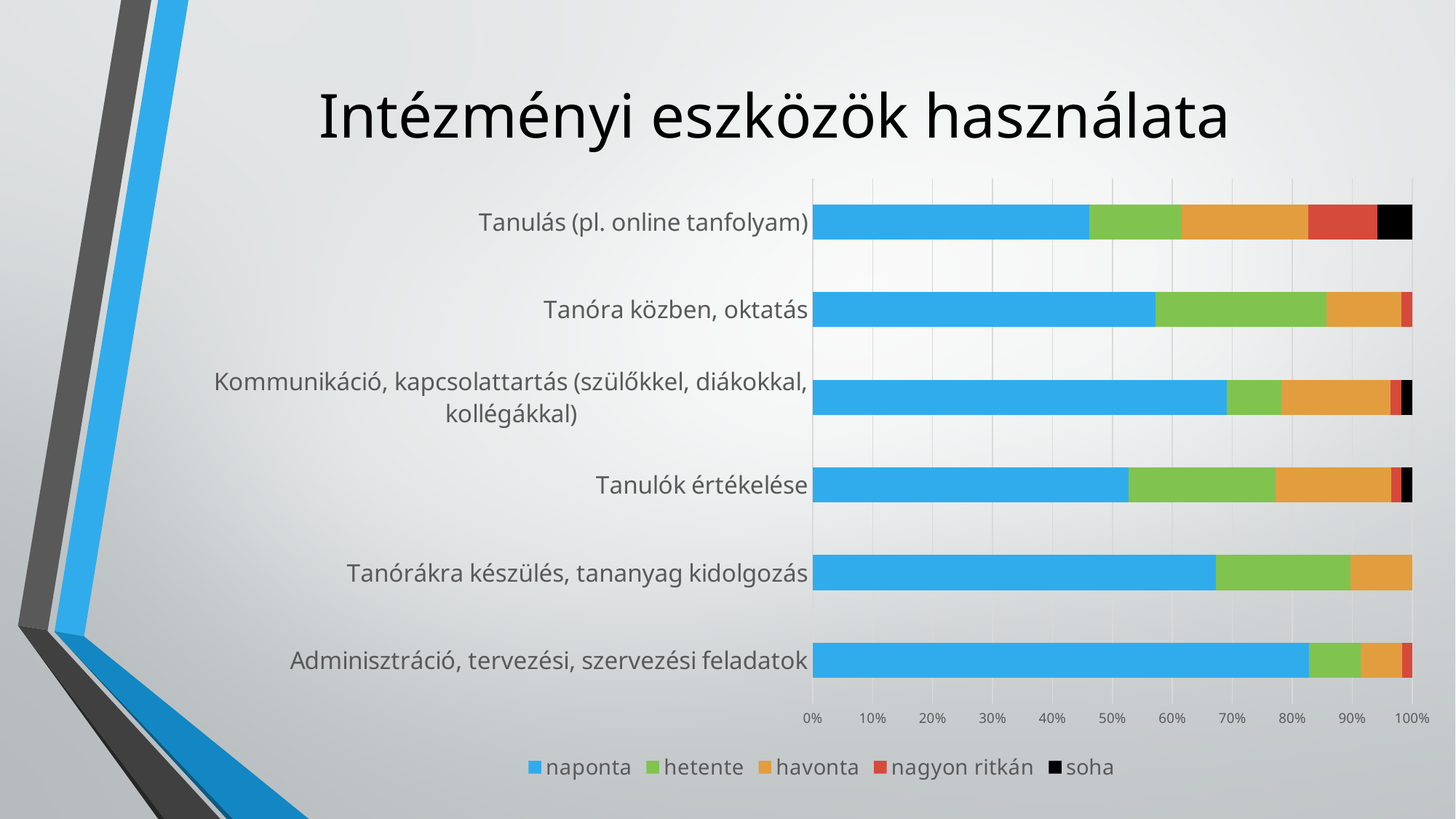
Is the 'naponta' share for 'Tanulás (pl. online tanfolyam)' greater or less than 50%? less Which colour represents the 'naponta' series in the chart? blue Which category has the largest 'naponta' share? Adminisztráció, tervezési, szervezési feladatok Is the 'naponta' share for 'Kommunikáció, kapcsolattartás (szülőkkel, diákokkal, kollégákkal)' greater or less than 60%? greater How many categories are plotted on the chart? 6 What is the title of the chart on the slide? Intézményi eszközök használata Which category has the largest 'soha' segment? Tanulás (pl. online tanfolyam) What kind of chart is shown on the slide? stacked bar chart Which category has the smallest 'naponta' share? Tanulás (pl. online tanfolyam) Which has a larger 'naponta' share: 'Kommunikáció, kapcsolattartás (szülőkkel, diákokkal, kollégákkal)' or 'Tanulók értékelése'? Kommunikáció, kapcsolattartás (szülőkkel, diákokkal, kollégákkal) Is the 'naponta' share for 'Adminisztráció, tervezési, szervezési feladatok' greater or less than 80%? greater How many series does the legend list? 5